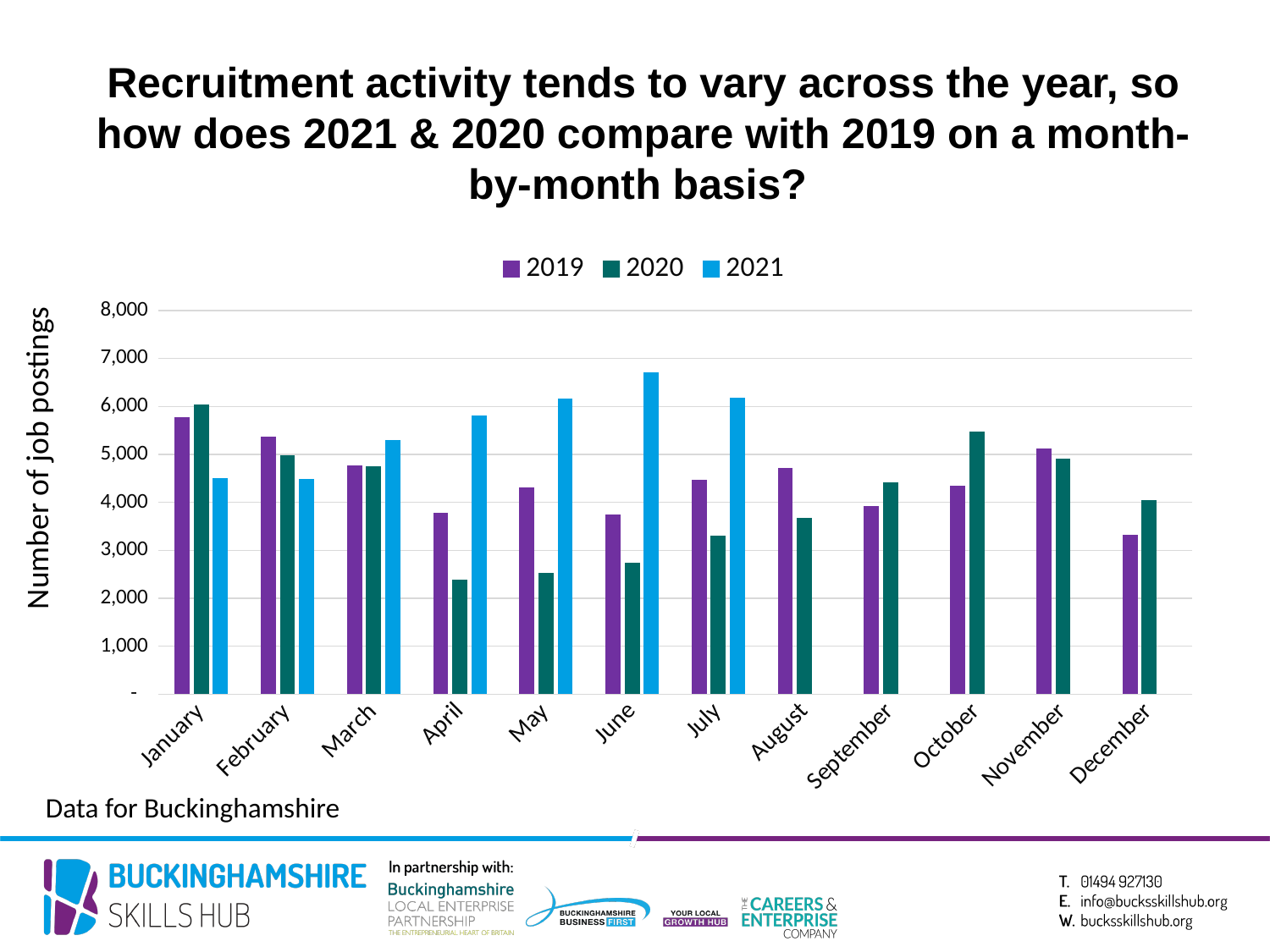
In January, which series has the larger value, 2019 or 2021? 2019 Which month has the highest value for the 2021 series? June Is the value for June 2021 greater or less than 6,000? greater What kind of chart is shown on the slide? bar chart Which month has the highest value for the 2020 series? January Which month has the lowest value for the 2019 series? December What is the label on the vertical axis? Number of job postings Do the 2021 values rise or fall from January to June? rise How many months are shown along the x axis? 12 In April, which series has the larger value, 2019 or 2021? 2021 Is the value for April 2020 greater or less than 3,000? less How many series does the legend list? 3